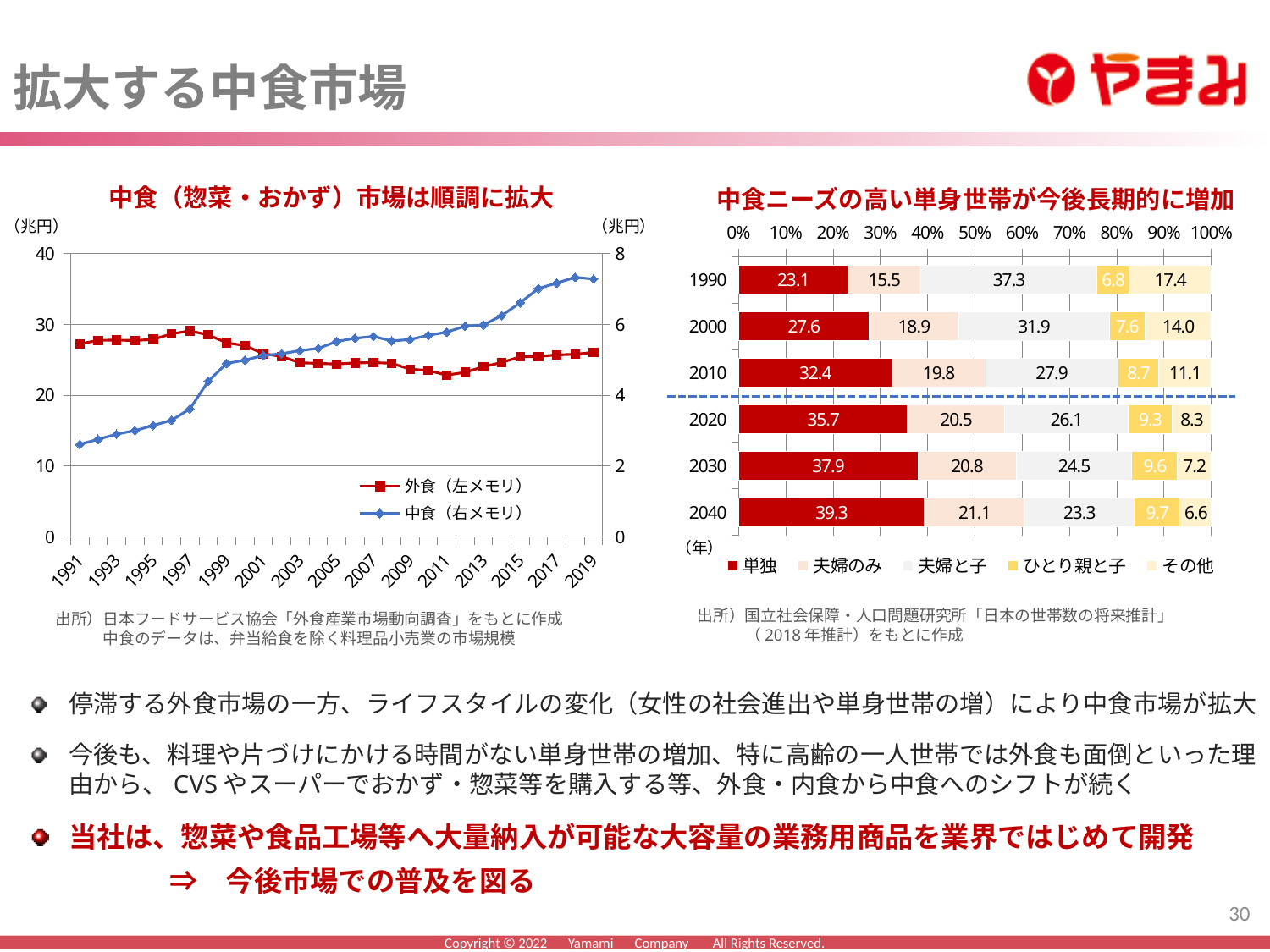
In the right chart, how many series does the legend list? 5 In the right chart (中食ニーズの高い単身世帯が今後長期的に増加), what is the value for 単独 in 2040? 39.3 In the left chart, is the value for 中食 in 2019 greater or less than 6 on the right axis? greater In the right chart, which year has the lowest value for その他? 2040 In the right chart, what is the difference between the 単独 values for 2040 and 1990? 16.2 In the right chart, what is the value for 夫婦と子 in 1990? 37.3 What kind of chart is the left chart (中食（惣菜・おかず）市場は順調に拡大)? Line chart In the right chart, how many years are shown? 6 In the left chart, does the 中食 series rise or fall from 1991 to 2019? Rise In the right chart, which is larger in 2010: 夫婦のみ or 夫婦と子? 夫婦と子 In the right chart, what is the value for ひとり親と子 in 2020? 9.3 In the right chart, which year has the highest value for 単独? 2040